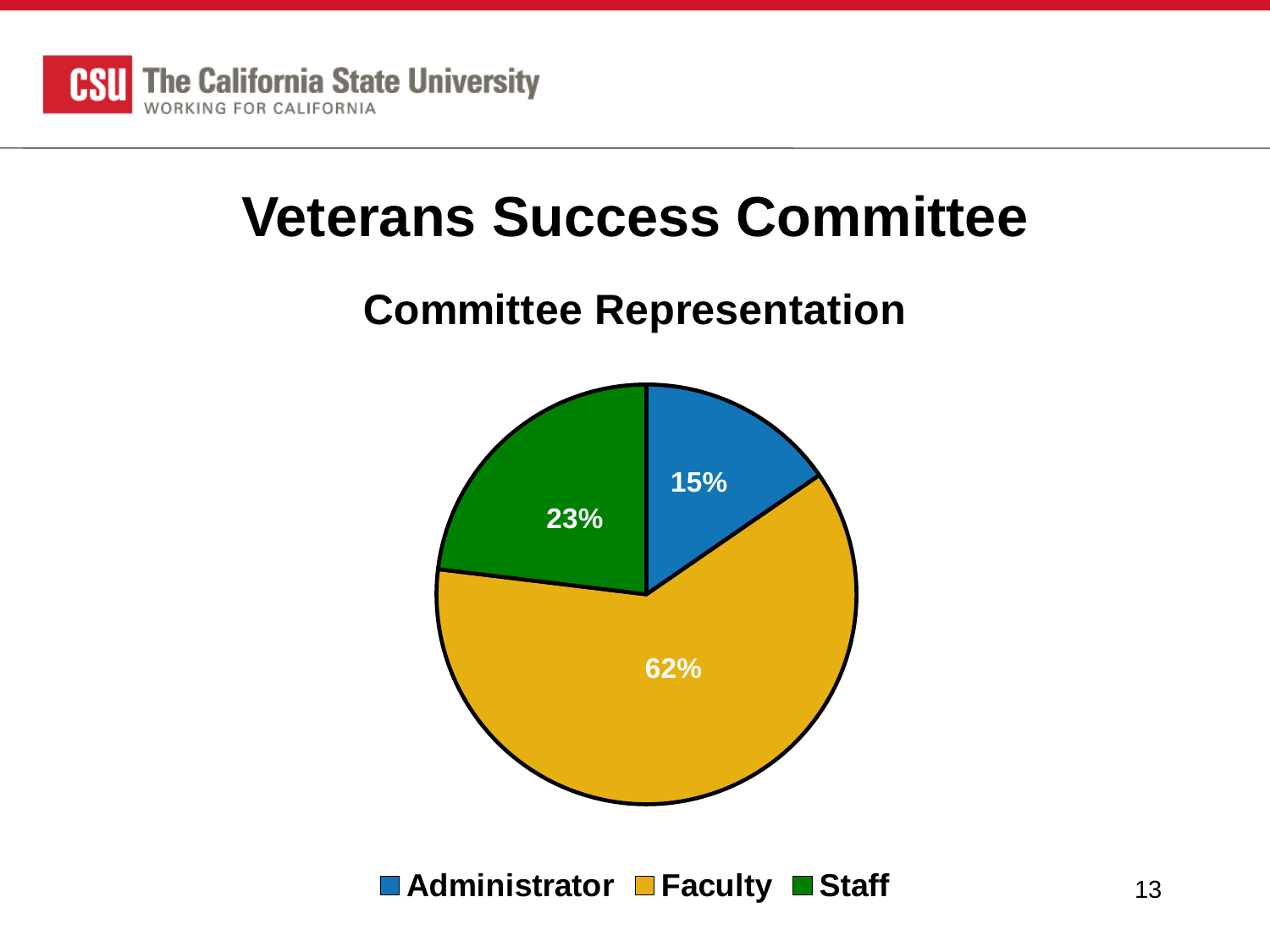
What is the title of the chart? Committee Representation What share of the Committee Representation pie is Staff? 23% What is the difference in percentage points between the Faculty and Staff shares? 39 What share of the Committee Representation pie is Administrator? 15% What is the difference in percentage points between the Staff and Administrator shares? 8 How many slices does the Committee Representation pie chart have? 3 What kind of chart is shown on the slide? Pie chart Which has a larger share, Staff or Administrator? Staff Which group has the smallest share of the Committee Representation pie? Administrator What share of the Committee Representation pie is Faculty? 62% Which colour represents Faculty in the pie chart? Yellow Which group has the largest share of the Committee Representation pie? Faculty